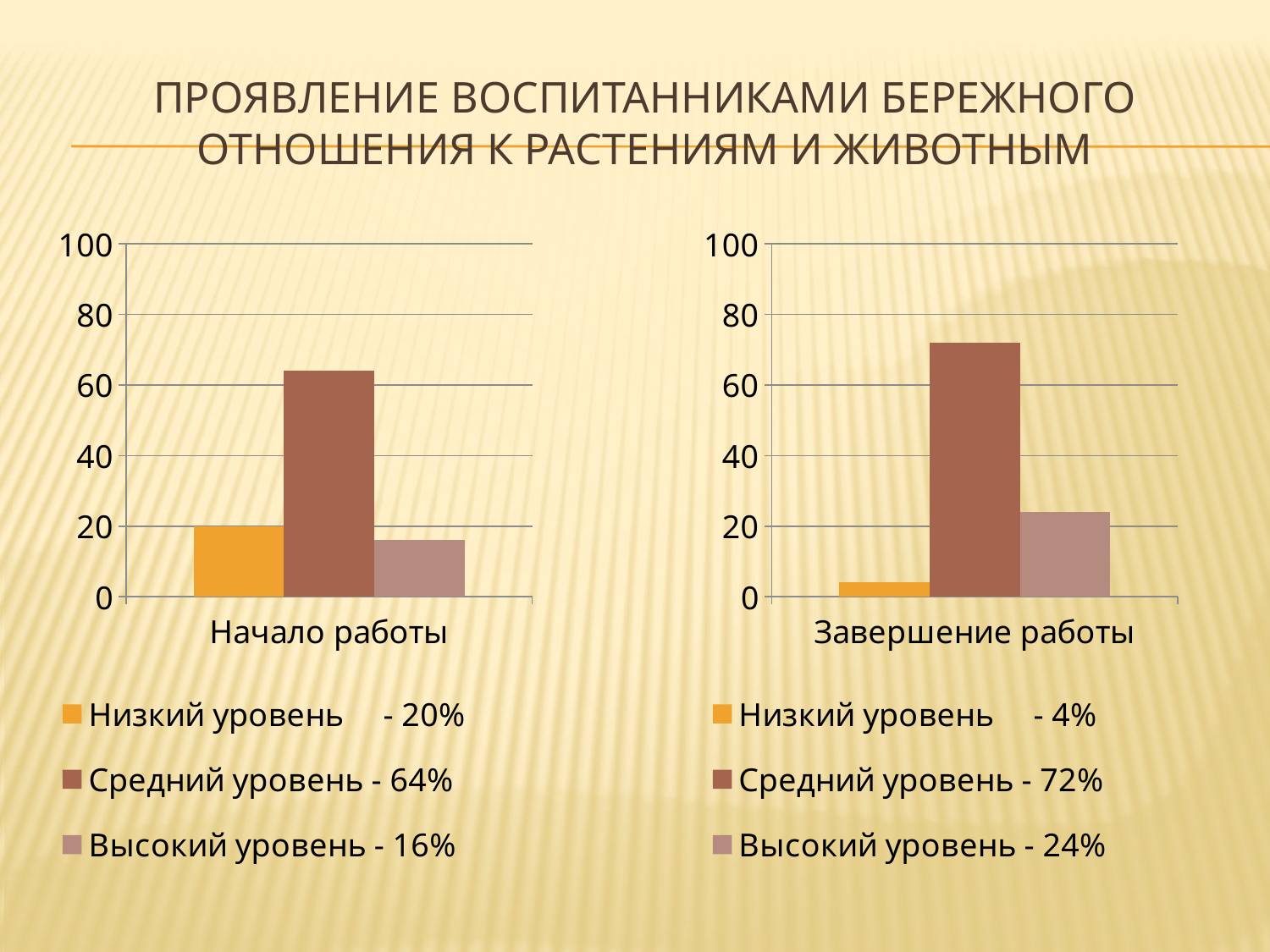
What is the category label on the x axis of the left chart? Начало работы On the right chart (Завершение работы), which level has the lowest value? Низкий уровень On the right chart (Завершение работы), what is the value for Высокий уровень? 24% What kind of chart is the right chart (Завершение работы)? Bar chart Which is larger: Высокий уровень on the left chart (Начало работы) or Высокий уровень on the right chart (Завершение работы)? Right chart (Завершение работы) On the left chart (Начало работы), what is the value for Низкий уровень? 20% On the left chart (Начало работы), what is the difference between Средний уровень and Высокий уровень? 48% What is the difference between the Низкий уровень value on the left chart (Начало работы) and on the right chart (Завершение работы)? 16% On the right chart (Завершение работы), what is the value for Средний уровень? 72% On the left chart (Начало работы), which level has the highest value? Средний уровень On the right chart (Завершение работы), is the value for Средний уровень greater or less than 60? greater How many series does the legend of the left chart (Начало работы) list? 3